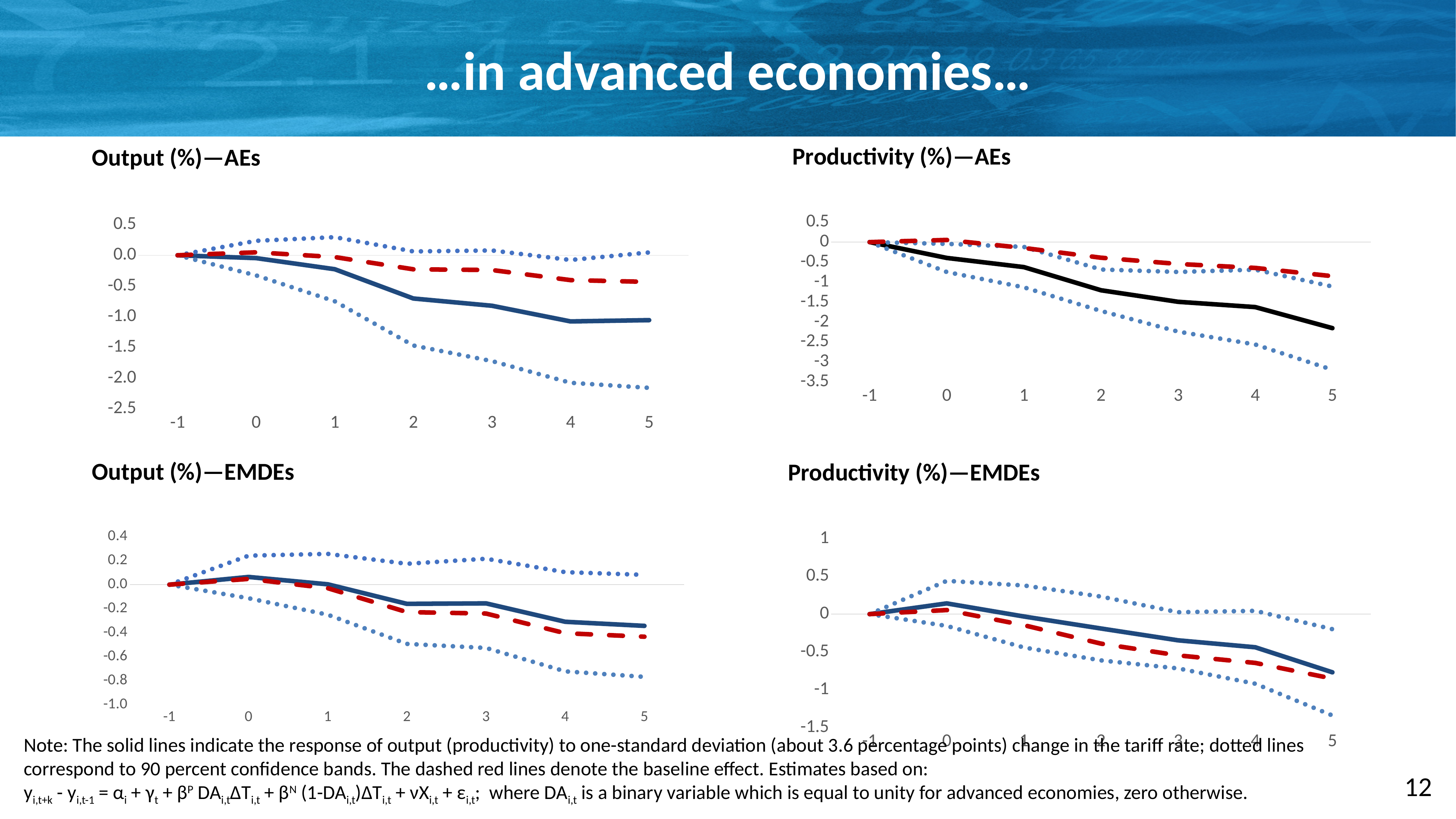
In the Output (%)—AEs chart, how many points are labelled on the x axis? 7 In the Productivity (%)—AEs chart, is the value of the solid line at x = 5 greater or less than -1.5? less In the Output (%)—EMDEs chart, is the value of the solid line at x = 5 greater or less than -0.2? less How many charts are shown on the slide? 4 In the Output (%)—AEs chart, does the solid line rise or fall from -1 to 5 on the x axis? fall In the Output (%)—AEs chart, is the value of the solid line at x = 5 greater or less than -1.5? greater In the Productivity (%)—AEs chart, what colour is the solid line? black What kind of chart is the Output (%)—AEs chart? line chart In the Productivity (%)—AEs chart, does the solid line rise or fall from -1 to 5 on the x axis? fall